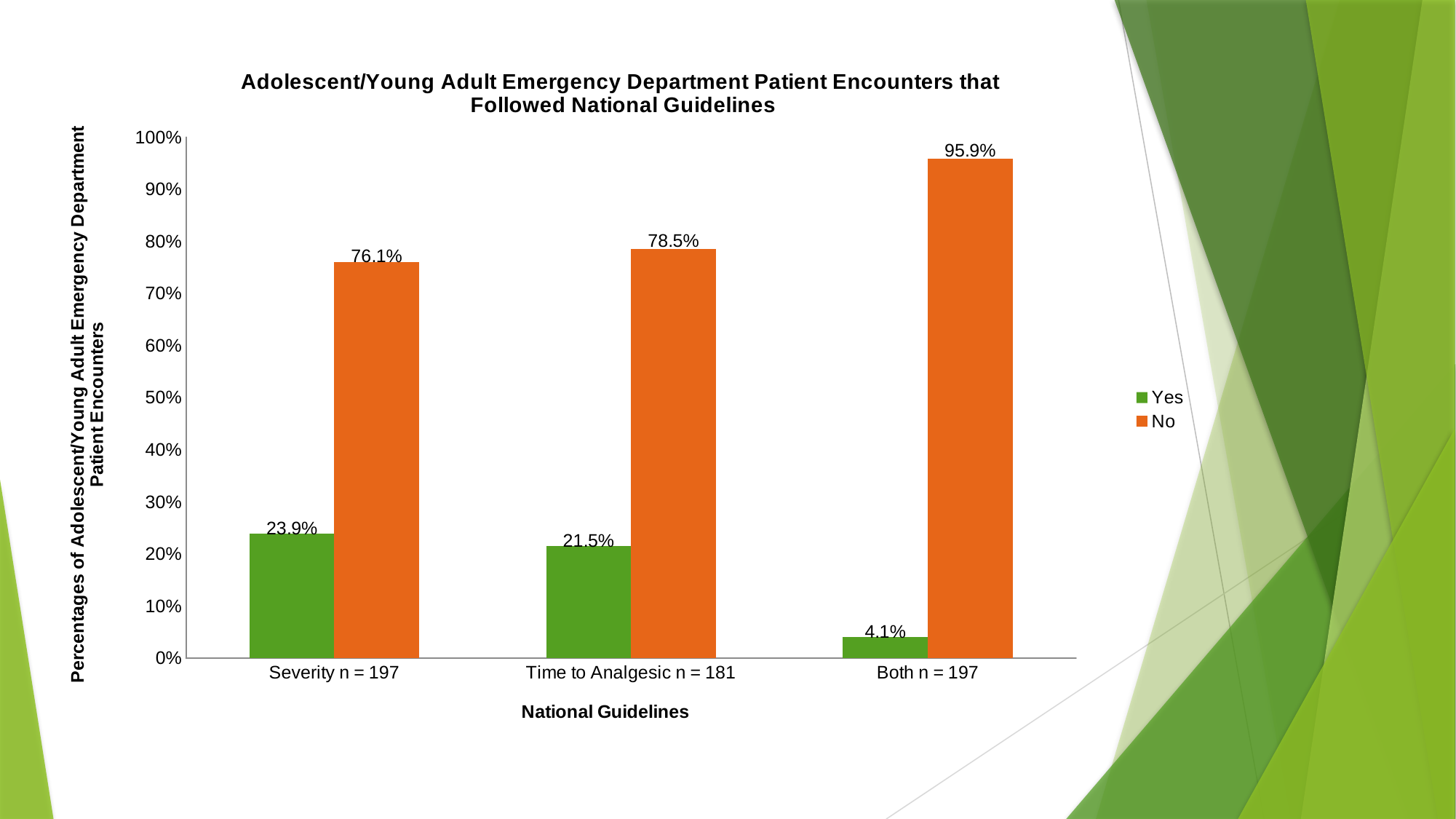
How many series does the legend list? 2 What is the difference between the 'No' and 'Yes' values for Severity n = 197? 52.2% Which category has the lowest 'Yes' value? Both n = 197 What kind of chart is shown on the slide? bar chart What is the 'Yes' value for Severity n = 197? 23.9% Which category has the highest 'No' value? Both n = 197 What is the 'No' value for Time to Analgesic n = 181? 78.5% How many categories are shown on the x axis? 3 Is the 'No' value for Time to Analgesic n = 181 greater or less than 70%? greater What is the x-axis title of the chart? National Guidelines Which is larger, the 'Yes' value for Severity n = 197 or the 'Yes' value for Time to Analgesic n = 181? Severity n = 197 What is the 'No' value for Both n = 197? 95.9%